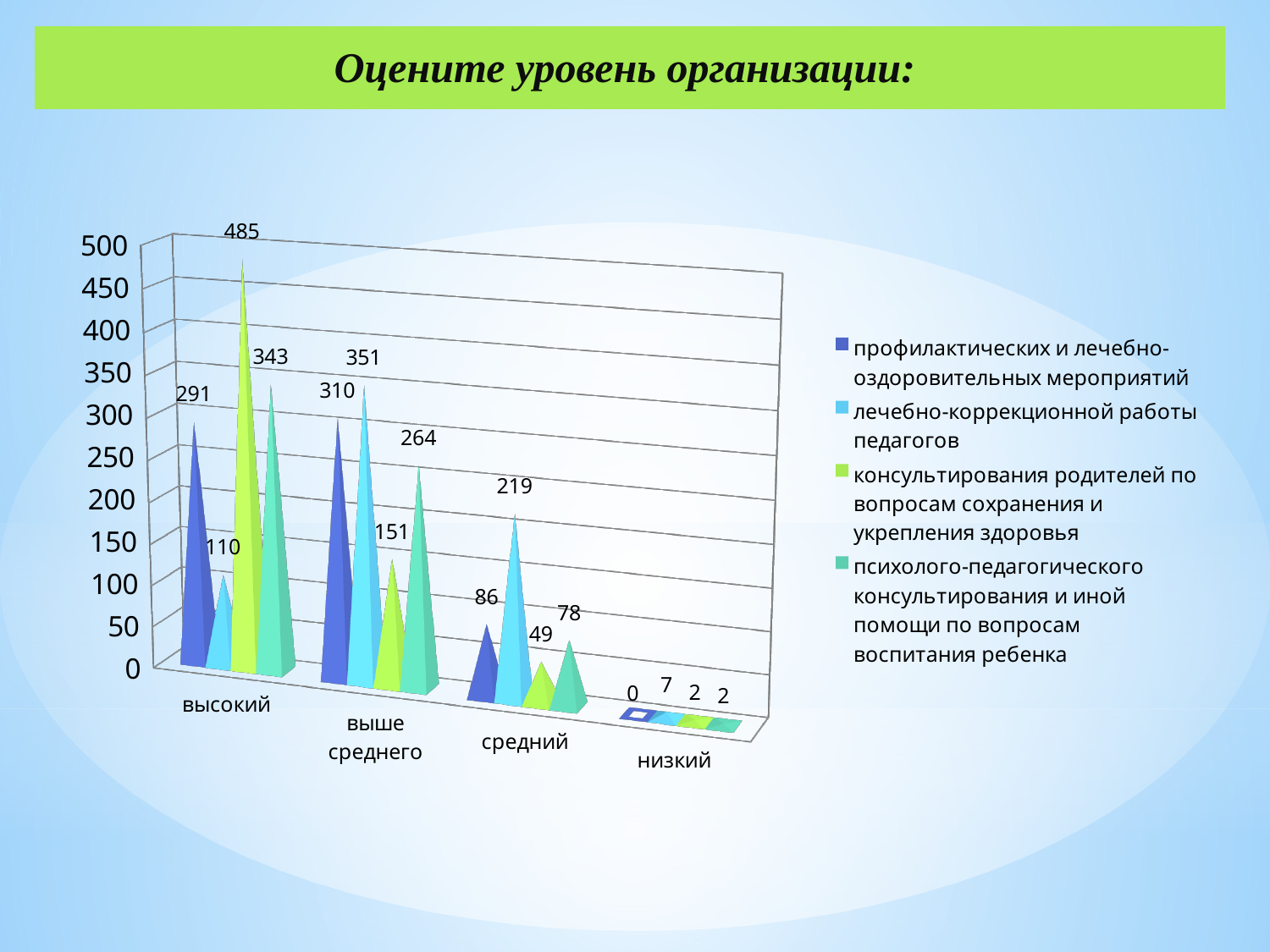
What is the value for 'консультирования родителей по вопросам сохранения и укрепления здоровья' in the 'высокий' category? 485 Which category has the lowest value for 'лечебно-коррекционной работы педагогов'? низкий How many categories are shown on the x axis? 4 What kind of chart is shown on the slide? bar chart What is the value for 'лечебно-коррекционной работы педагогов' in the 'выше среднего' category? 351 What is the value for 'профилактических и лечебно-оздоровительных мероприятий' in the 'средний' category? 86 What is the value for 'психолого-педагогического консультирования и иной помощи по вопросам воспитания ребенка' in the 'низкий' category? 2 Which is larger in the 'средний' category: 'лечебно-коррекционной работы педагогов' or 'психолого-педагогического консультирования и иной помощи по вопросам воспитания ребенка'? лечебно-коррекционной работы педагогов How many series does the legend list? 4 What is the difference between the 'высокий' and 'выше среднего' values for 'профилактических и лечебно-оздоровительных мероприятий'? 19 Which category has the highest value for 'консультирования родителей по вопросам сохранения и укрепления здоровья'? высокий What is the title of the slide? Оцените уровень организации: